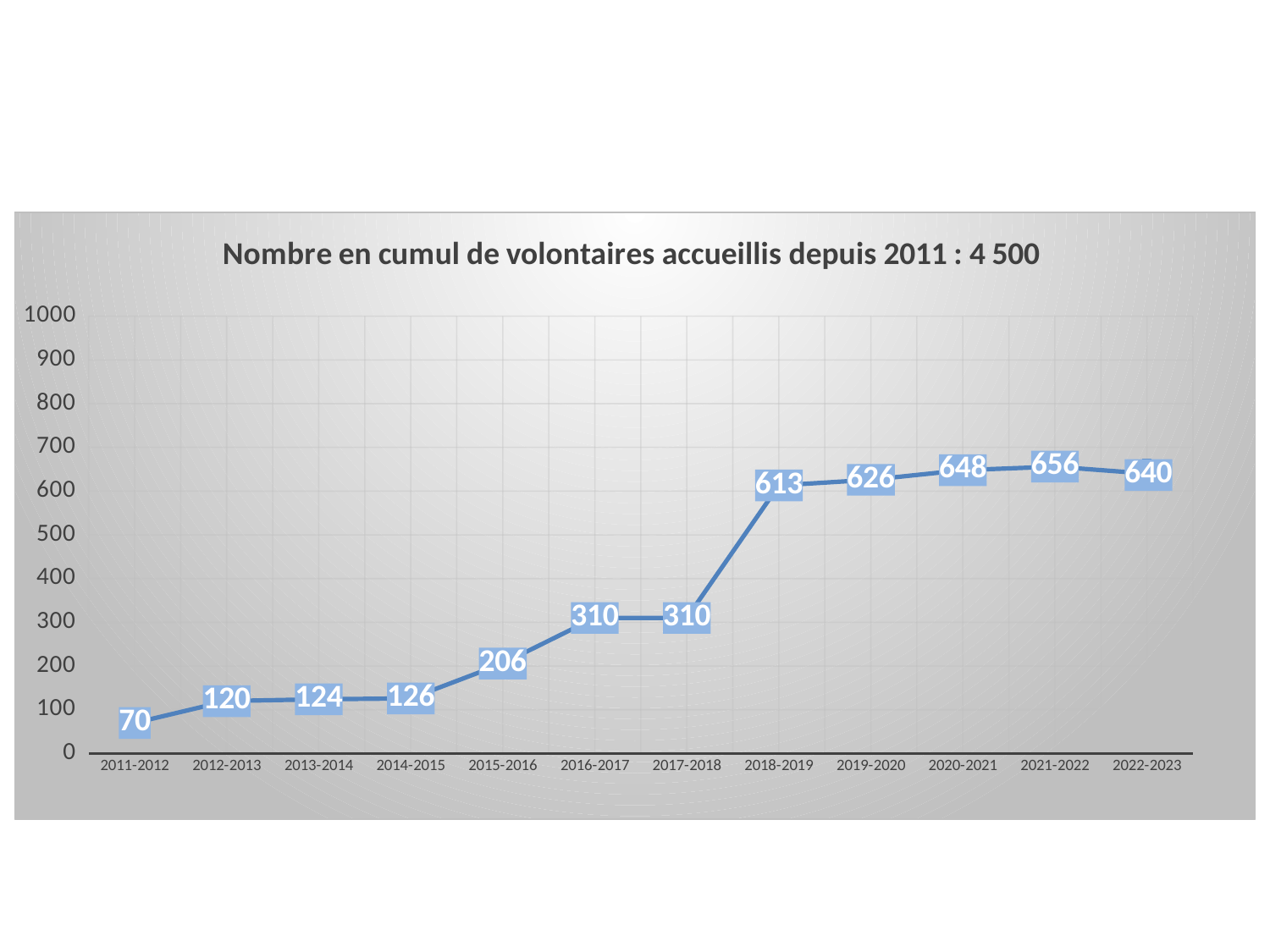
Which period has the lowest value? 2011-2012 What is the difference between the values for 2018-2019 and 2017-2018? 303 Is the value for 2020-2021 greater or less than 600? greater What is the difference between the values for 2021-2022 and 2022-2023? 16 Which is larger, the value for 2015-2016 or the value for 2014-2015? 2015-2016 What is the value for 2022-2023? 640 How many periods are plotted on the x axis? 12 What is the value for 2018-2019? 613 What is the value for 2011-2012? 70 Which period has the highest value? 2021-2022 What is the title of the chart? Nombre en cumul de volontaires accueillis depuis 2011 : 4 500 What kind of chart is shown? line chart